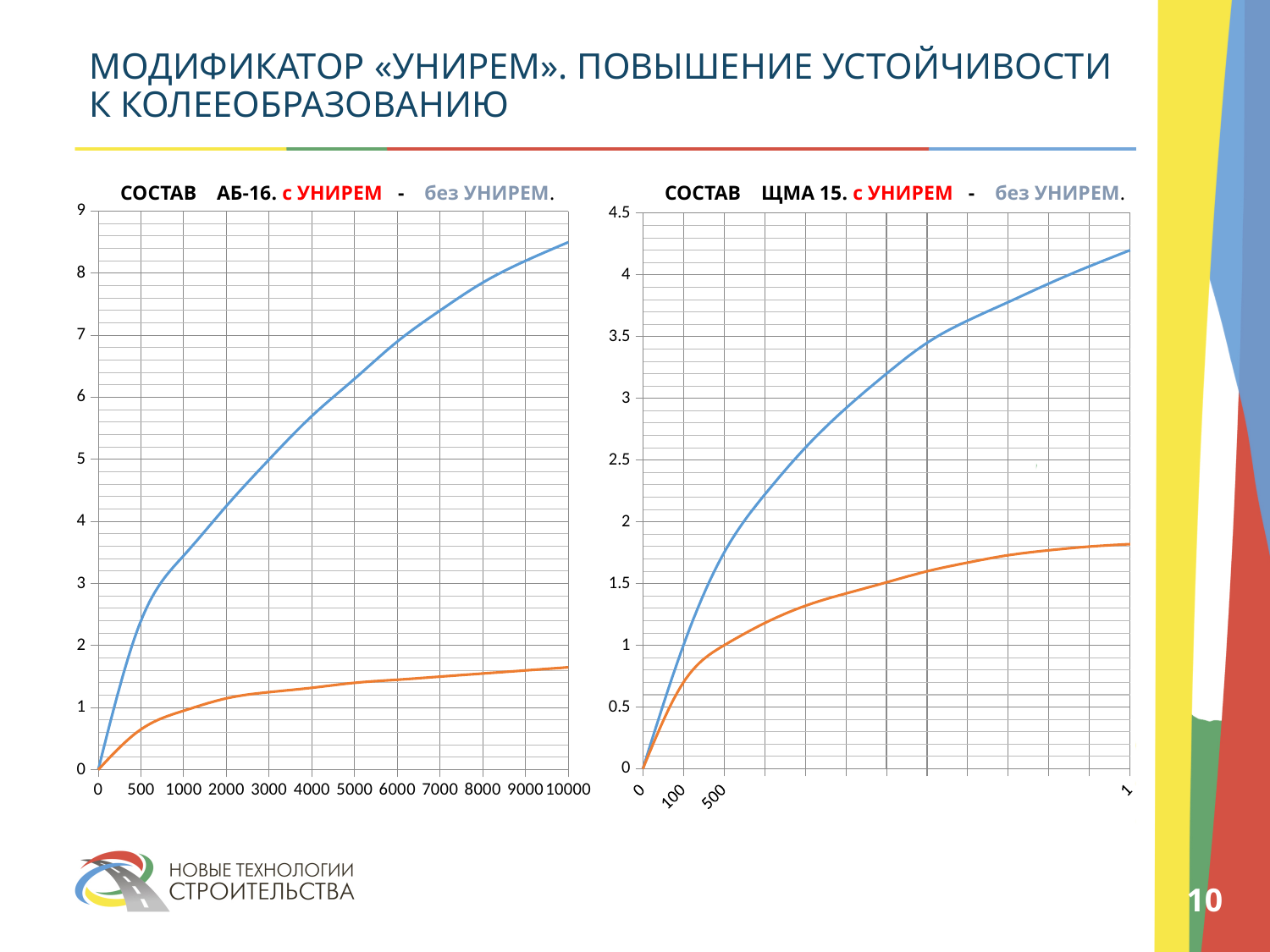
How many lines are plotted in the left chart (СОСТАВ АБ-16)? 2 In the left chart (СОСТАВ АБ-16), which line is higher at x = 10000, the blue line or the orange line? the blue line In the left chart (СОСТАВ АБ-16), is the value of the blue line at x = 10000 greater or less than 8? greater What kind of chart is the right chart titled "СОСТАВ ЩМА 15"? line chart In the right chart (СОСТАВ ЩМА 15), is the final value of the orange line greater or less than 2? less In the right chart (СОСТАВ ЩМА 15), is the final value of the blue line greater or less than 4? greater In the left chart (СОСТАВ АБ-16), do the plotted lines rise or fall as the x-axis value increases? rise What is the highest value shown on the y axis of the right chart (СОСТАВ ЩМА 15)? 4.5 What kind of chart is the left chart titled "СОСТАВ АБ-16"? line chart In the right chart (СОСТАВ ЩМА 15), do the plotted lines rise or fall along the x axis? rise